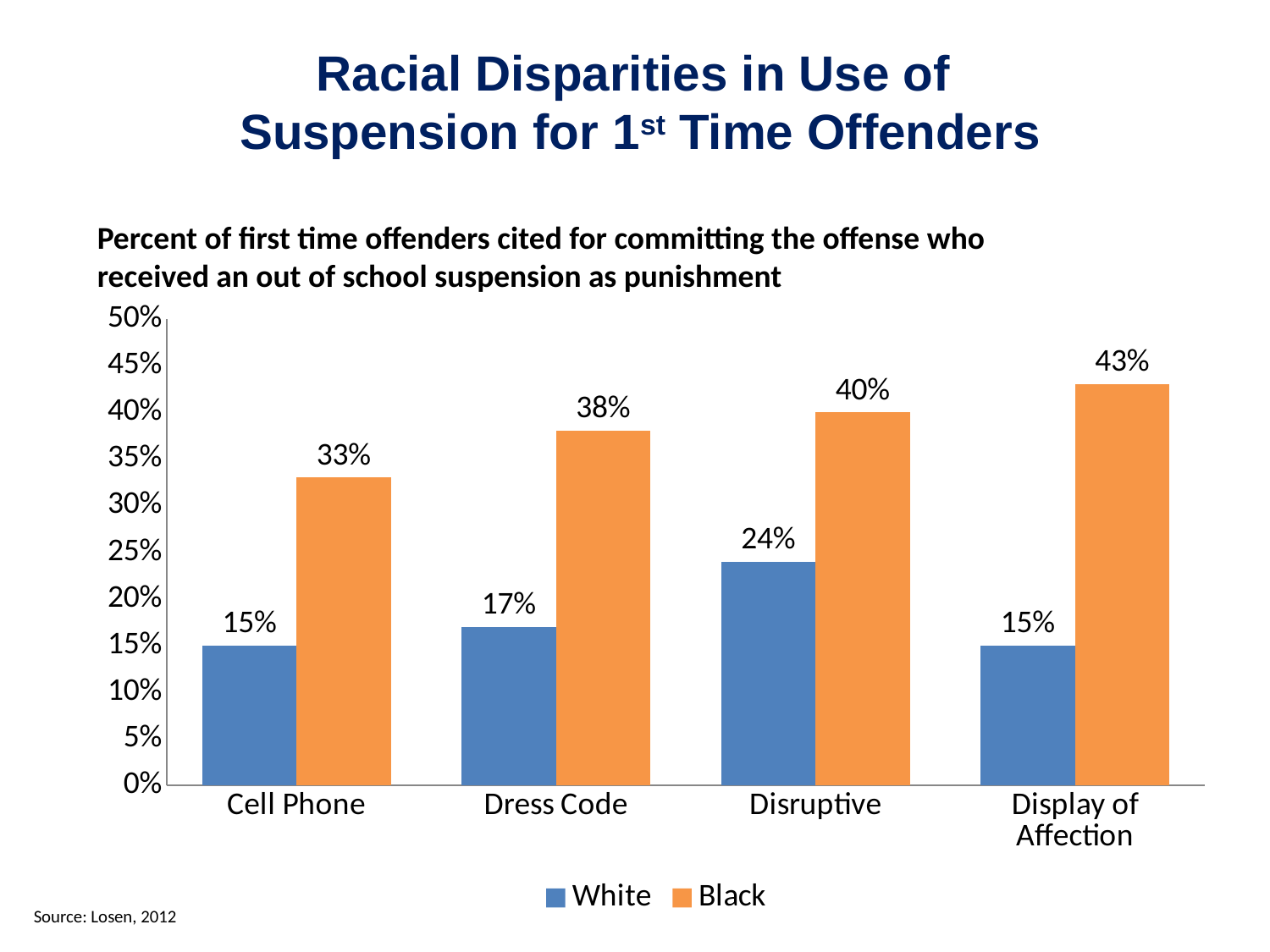
What is the difference between the Black and White suspension rates for Dress Code? 21% What percent of Black first time offenders cited for a Dress Code offense received an out of school suspension? 38% Which offense category has the highest suspension rate for Black students? Display of Affection What kind of chart is shown on the slide? Bar chart What percent of White first time offenders cited for a Cell Phone offense received an out of school suspension? 15% What is the value for Black students in the Disruptive category? 40% Which offense category has the highest suspension rate for White students? Disruptive For the Disruptive category, which group has the higher suspension rate, White or Black? Black How many series does the legend list? 2 Which offense category has the lowest suspension rate for Black students? Cell Phone How many offense categories are shown on the x axis? 4 What is the difference between the Black and White suspension rates for Display of Affection? 28%